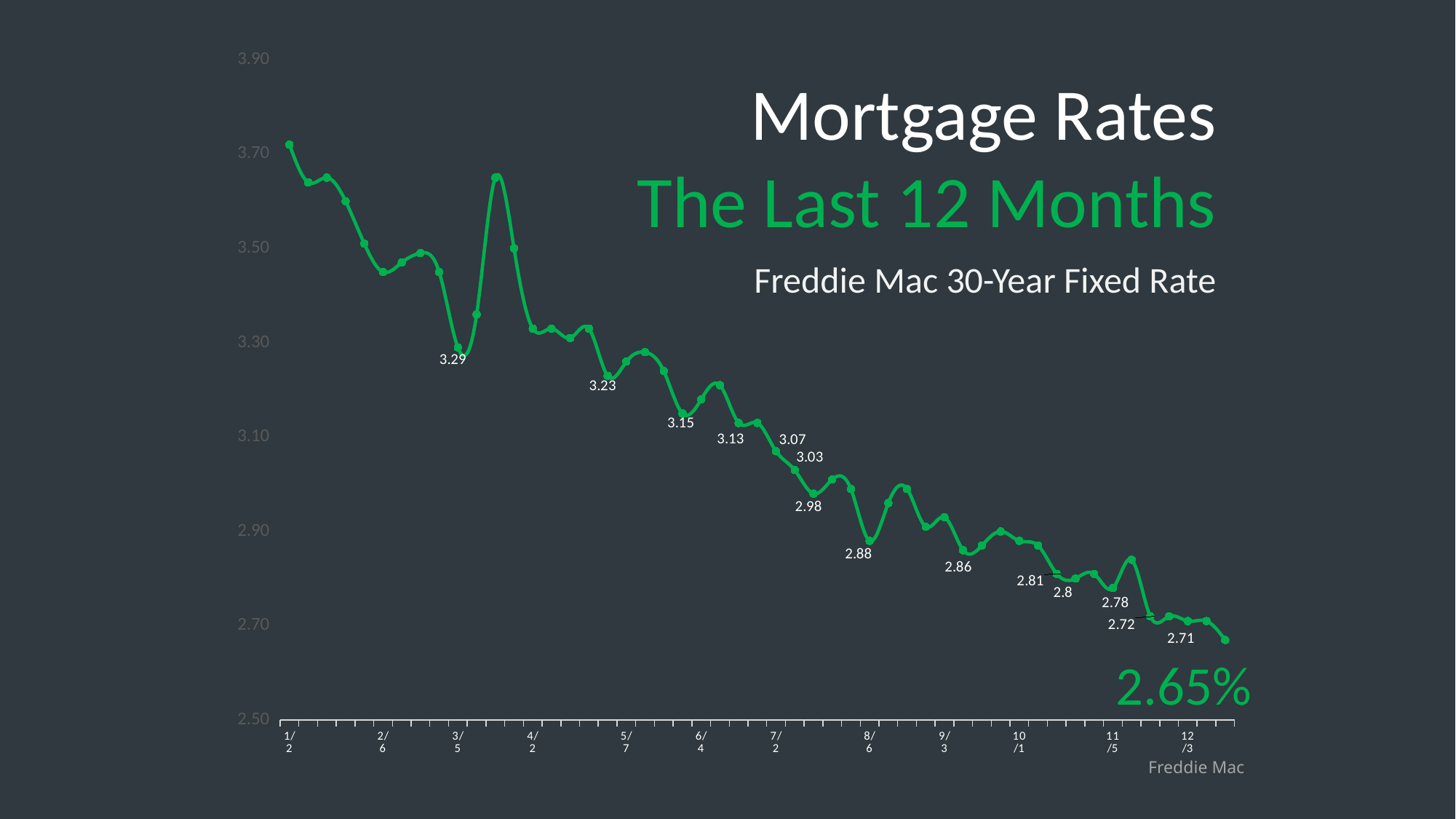
What is the final rate shown at the end of the line? 2.65% What kind of chart is shown on the slide? line chart What is the mortgage rate labeled at 3/5? 3.29 At which x-axis date is the mortgage rate highest? 1/2 Which is larger, the labeled value 2.88 or the labeled value 2.86? 2.88 Is the value at 1/2 greater or less than 3.50? greater What is the difference between the labeled value 3.29 and the final rate of 2.65%? 0.64 What is the difference between the labeled values 3.29 and 3.23? 0.06 What is the source cited at the bottom right of the chart? Freddie Mac Overall, do the mortgage rates rise or fall from 1/2 to the end of the chart? fall Is the value at 12/3 greater or less than 2.90? less What is the lowest rate shown on the chart? 2.65%